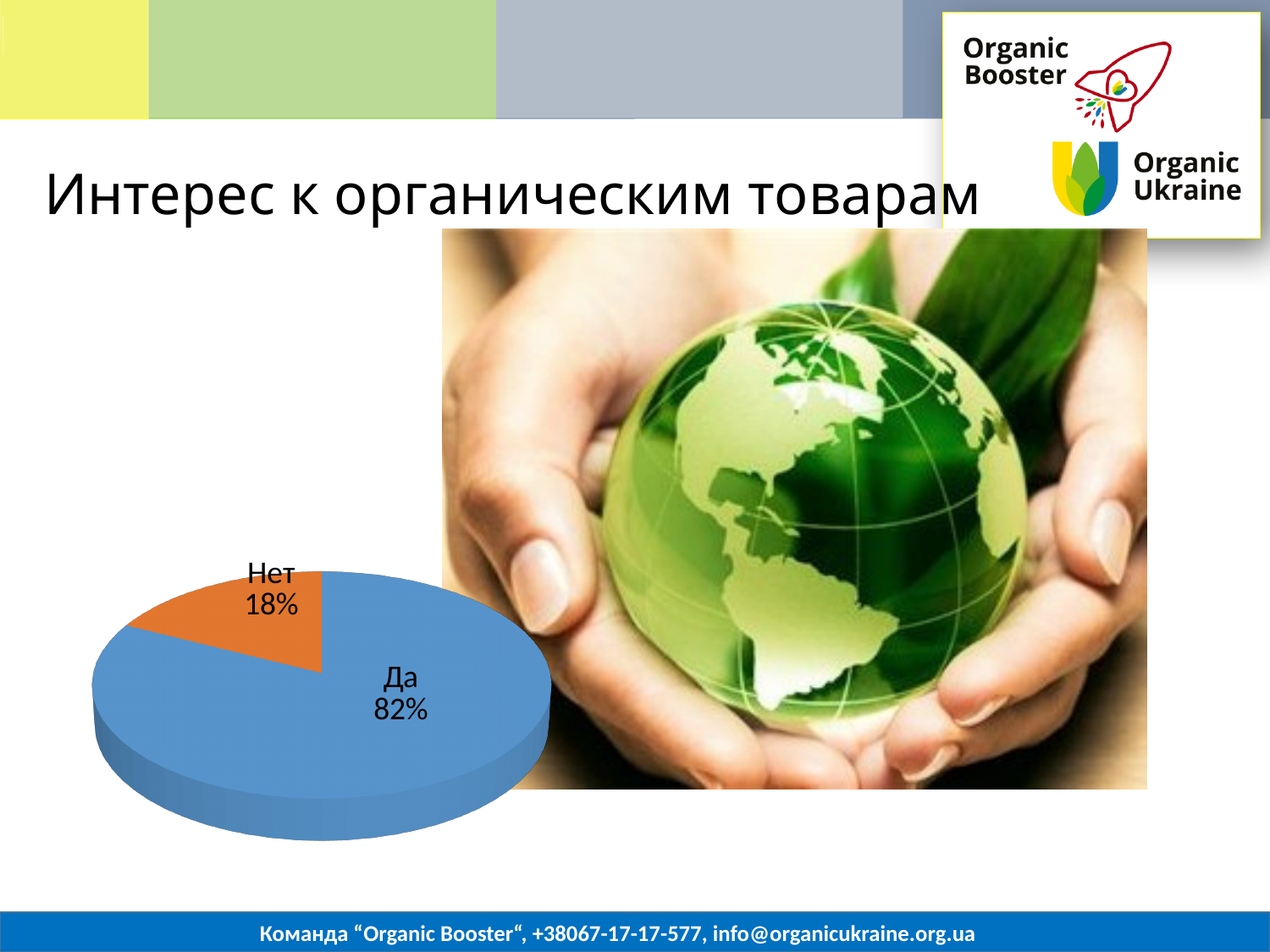
What share of the pie chart is labelled "Нет"? 18% What share of the pie chart is labelled "Да"? 82% Which slice of the pie chart is the smallest? Нет What colour is the "Да" slice of the pie chart? Blue What kind of chart is shown on the slide? Pie chart Which slice of the pie chart is the largest? Да What colour is the "Нет" slice of the pie chart? Orange How many slices does the pie chart have? 2 Which is larger, the "Да" slice or the "Нет" slice? Да What is the difference in percentage points between the "Да" and "Нет" slices? 64